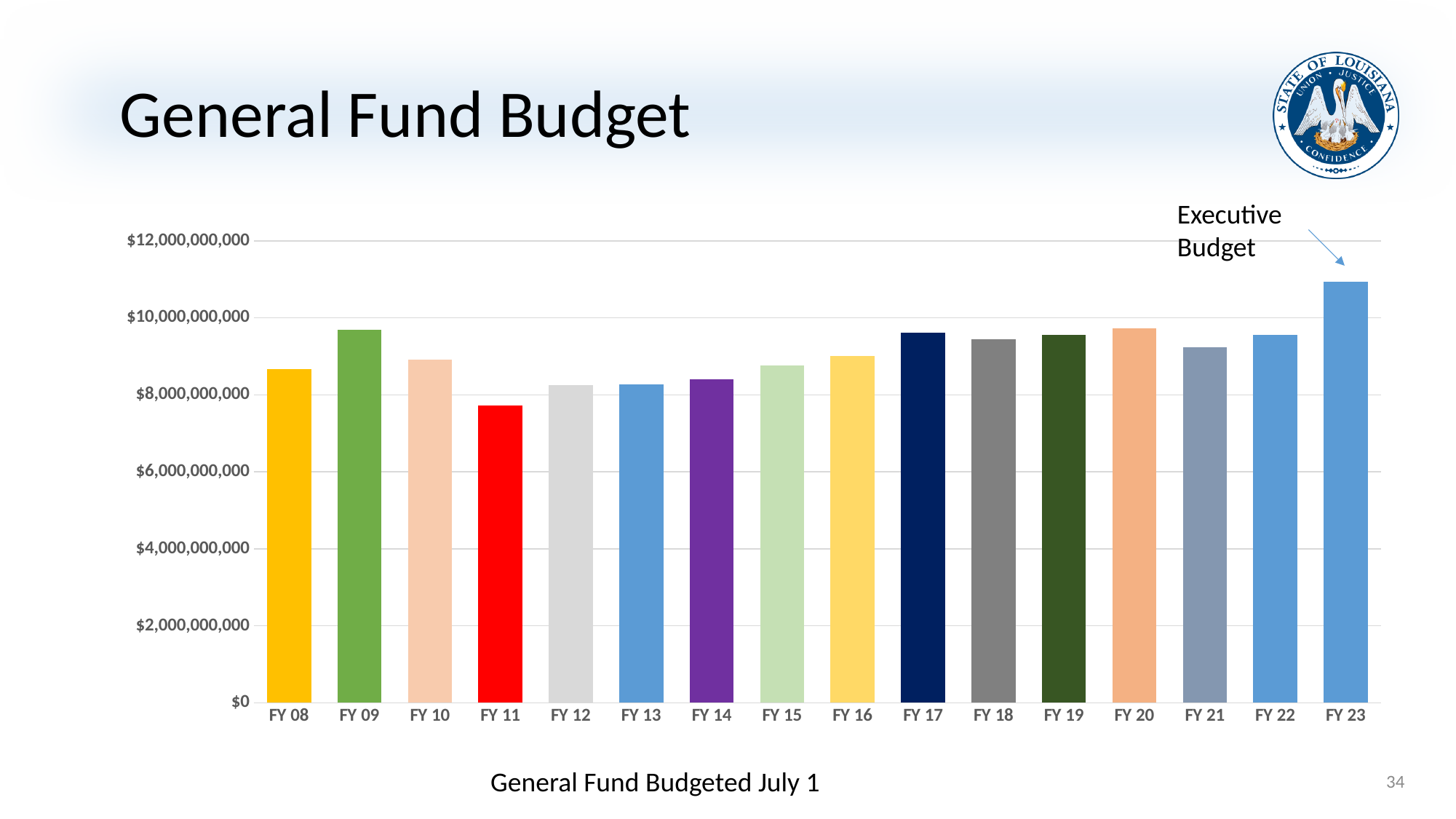
Which fiscal year has the highest General Fund budget? FY 23 Do the values rise or fall from FY 21 to FY 23? Rise How many fiscal years are plotted on the chart? 16 Which fiscal year's bar is labelled with the annotation "Executive Budget"? FY 23 Is the value for FY 11 greater or less than $8,000,000,000? less Is the value for FY 08 greater or less than $8,000,000,000? greater Is the value for FY 09 greater or less than $10,000,000,000? less What kind of chart is shown on the slide? Bar chart Which fiscal year has the lowest General Fund budget? FY 11 Which is larger, the value for FY 11 or the value for FY 14? FY 14 Which is larger, the value for FY 09 or the value for FY 12? FY 09